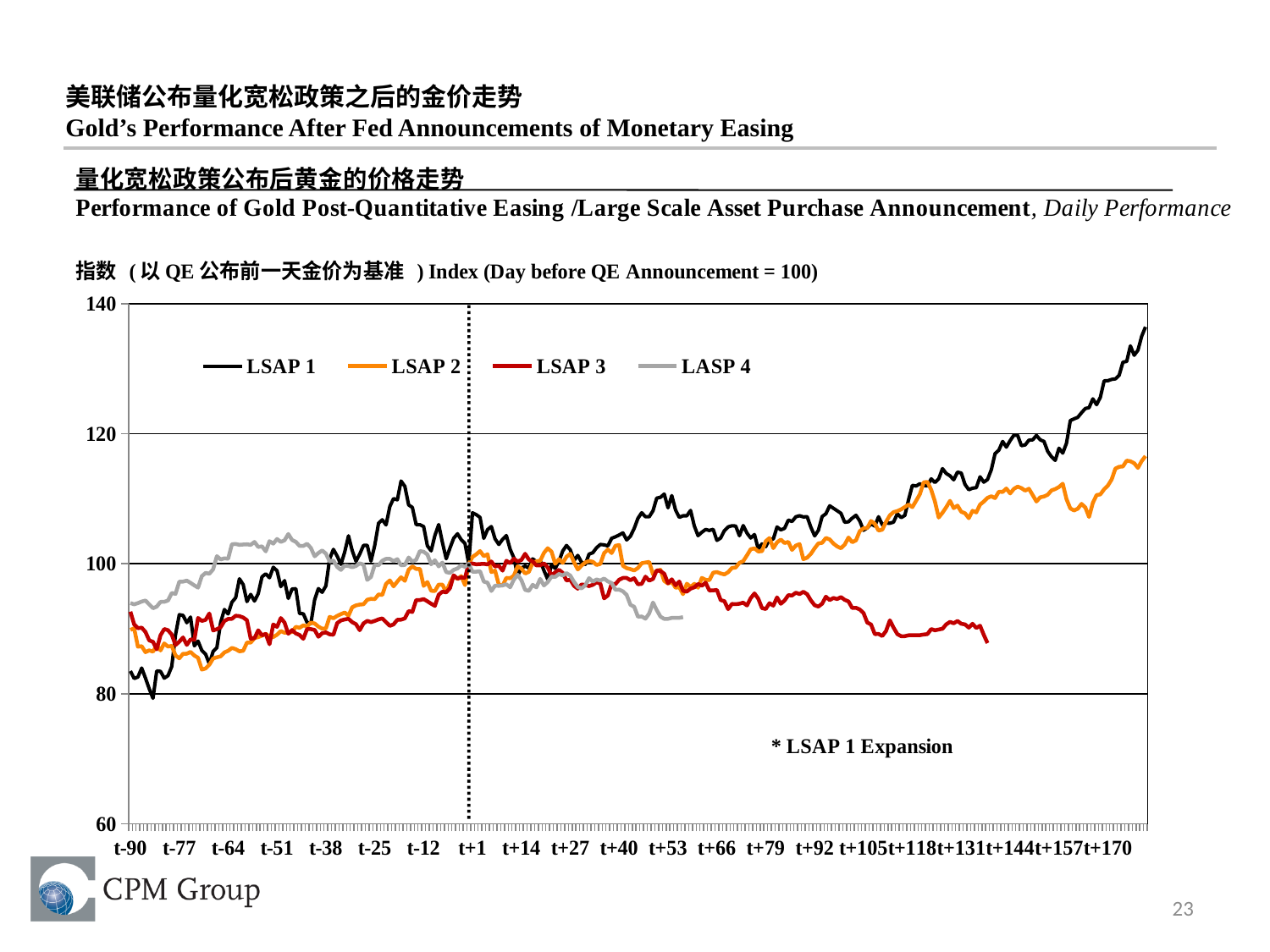
Is the final plotted value for LASP 4 (around t+53) greater or less than 100? less Is the value for LSAP 1 at t-90 greater or less than 100? less Which series reaches the highest value on the chart? LSAP 1 How many series does the legend list? 4 What kind of chart is shown on the slide? line chart After the announcement (t+1), does the LSAP 3 line generally rise or fall? fall At t+170, which series is higher, LSAP 1 or LSAP 2? LSAP 1 Is the value for LSAP 1 at t+170 greater or less than 120? greater What are the series names listed in the legend? LSAP 1, LSAP 2, LSAP 3, LASP 4 What index value does the chart use for the day before the QE announcement? 100